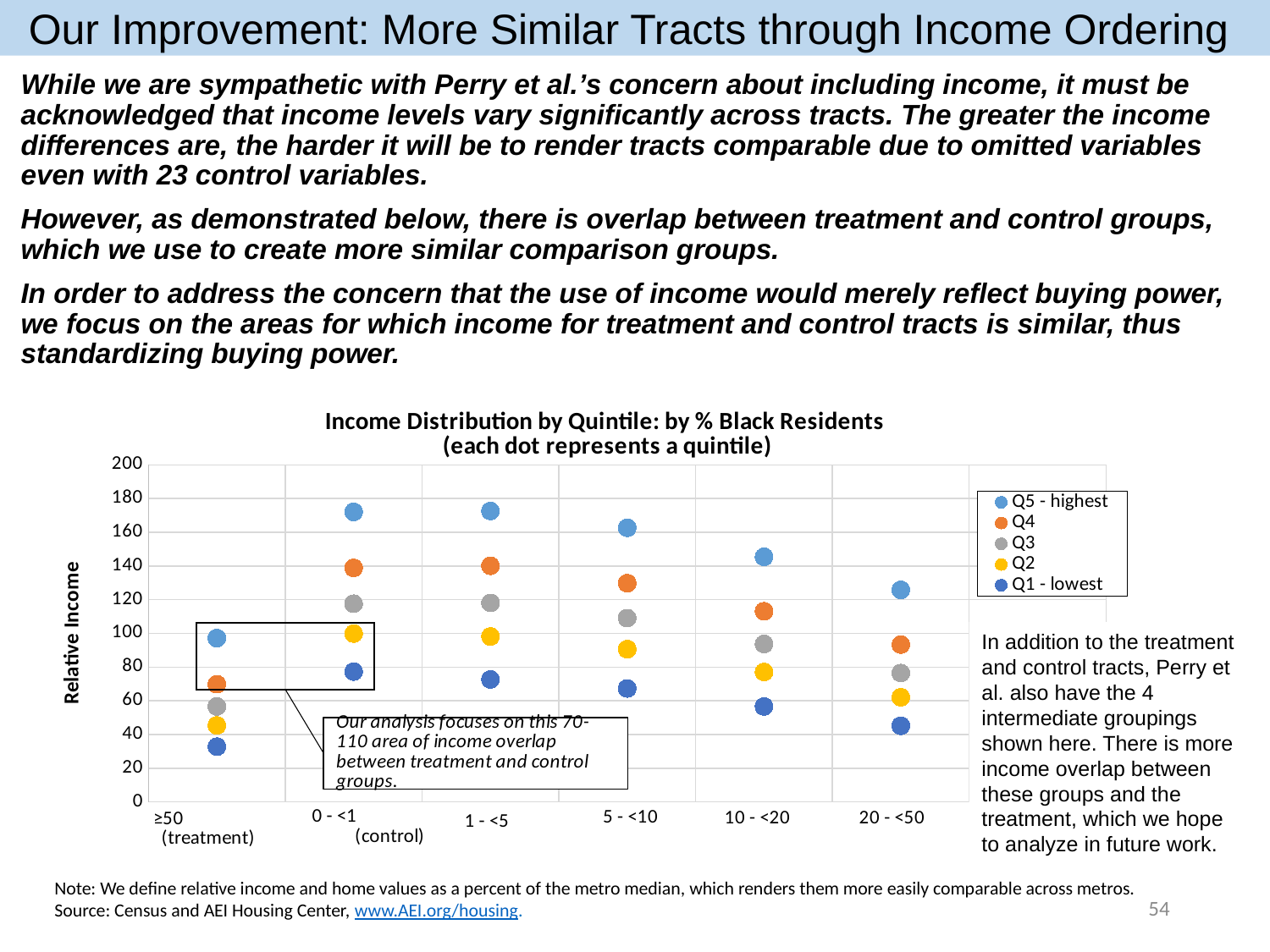
Which category has the lowest Q5 - highest value? ≥50 (treatment) Is the Q1 - lowest value for the 20 - <50 category greater or less than 60? less Which category has the lowest Q1 - lowest value? ≥50 (treatment) How many series does the chart legend list? 5 Is the Q5 - highest value for the 0 - <1 (control) category greater or less than 160? greater How many categories are shown along the x axis of the chart? 6 Which is larger: the Q4 value for 5 - <10 or the Q4 value for 10 - <20? 5 - <10 Is the Q3 value for the 1 - <5 category greater or less than 100? greater From the 1 - <5 category to the 20 - <50 category, do the Q5 - highest values rise or fall? fall What kind of chart is shown on the slide? scatter chart